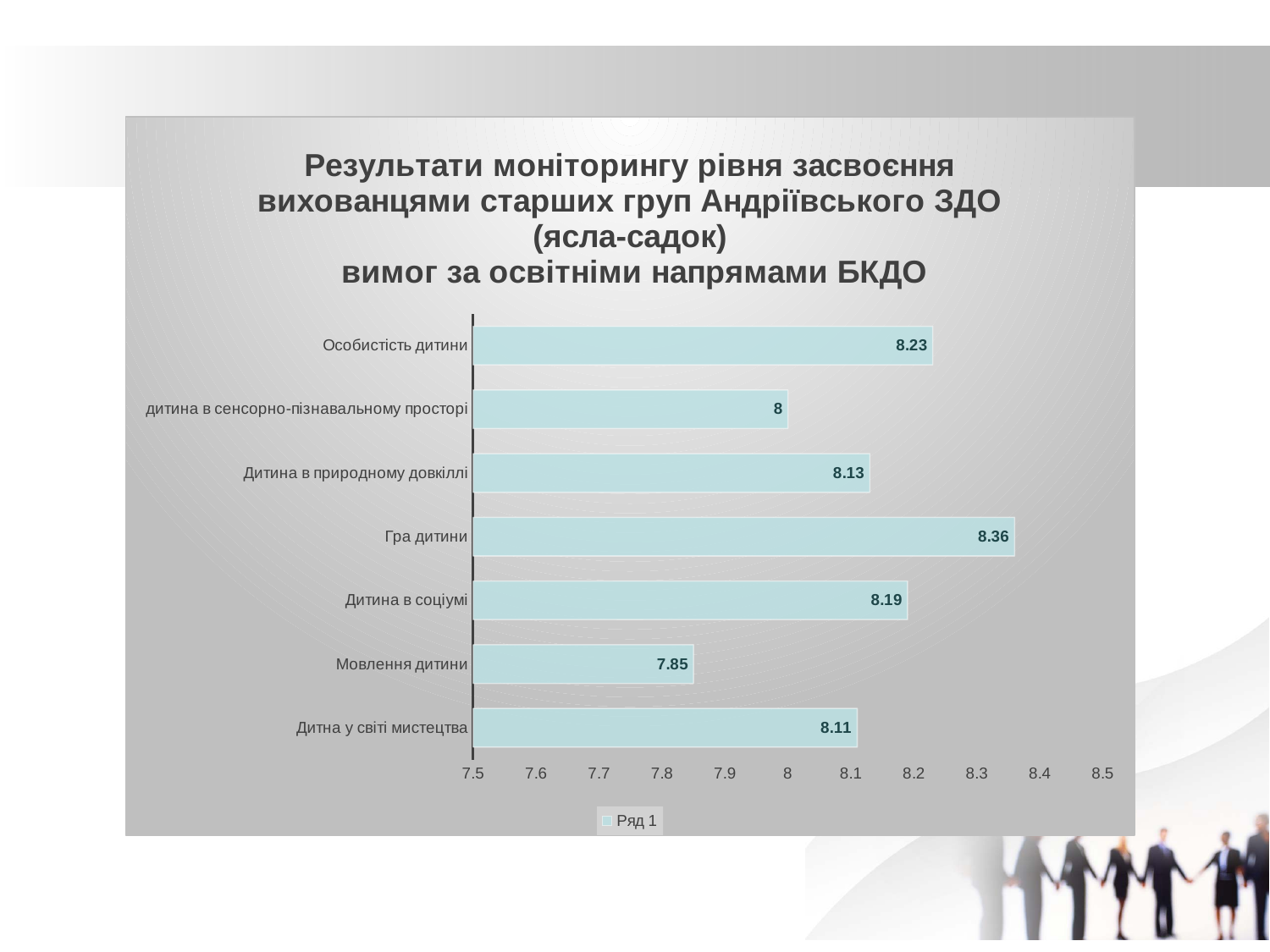
What kind of chart is shown on the slide? bar chart Which is larger, the value for "Особистість дитини" or the value for "Дитина в природному довкіллі"? Особистість дитини What is the value for "Мовлення дитини"? 7.85 Which category has the lowest value? Мовлення дитини What is the value for "дитина в сенсорно-пізнавальному просторі"? 8 What is the difference between the values for "Гра дитини" and "Мовлення дитини"? 0.51 How many categories are shown in the chart? 7 Is the value for "Дитна у світі мистецтва" greater or less than 8? greater How many series does the legend list? 1 What is the value for "Гра дитини"? 8.36 Which category has the highest value? Гра дитини What is the value for "Дитина в соціумі"? 8.19